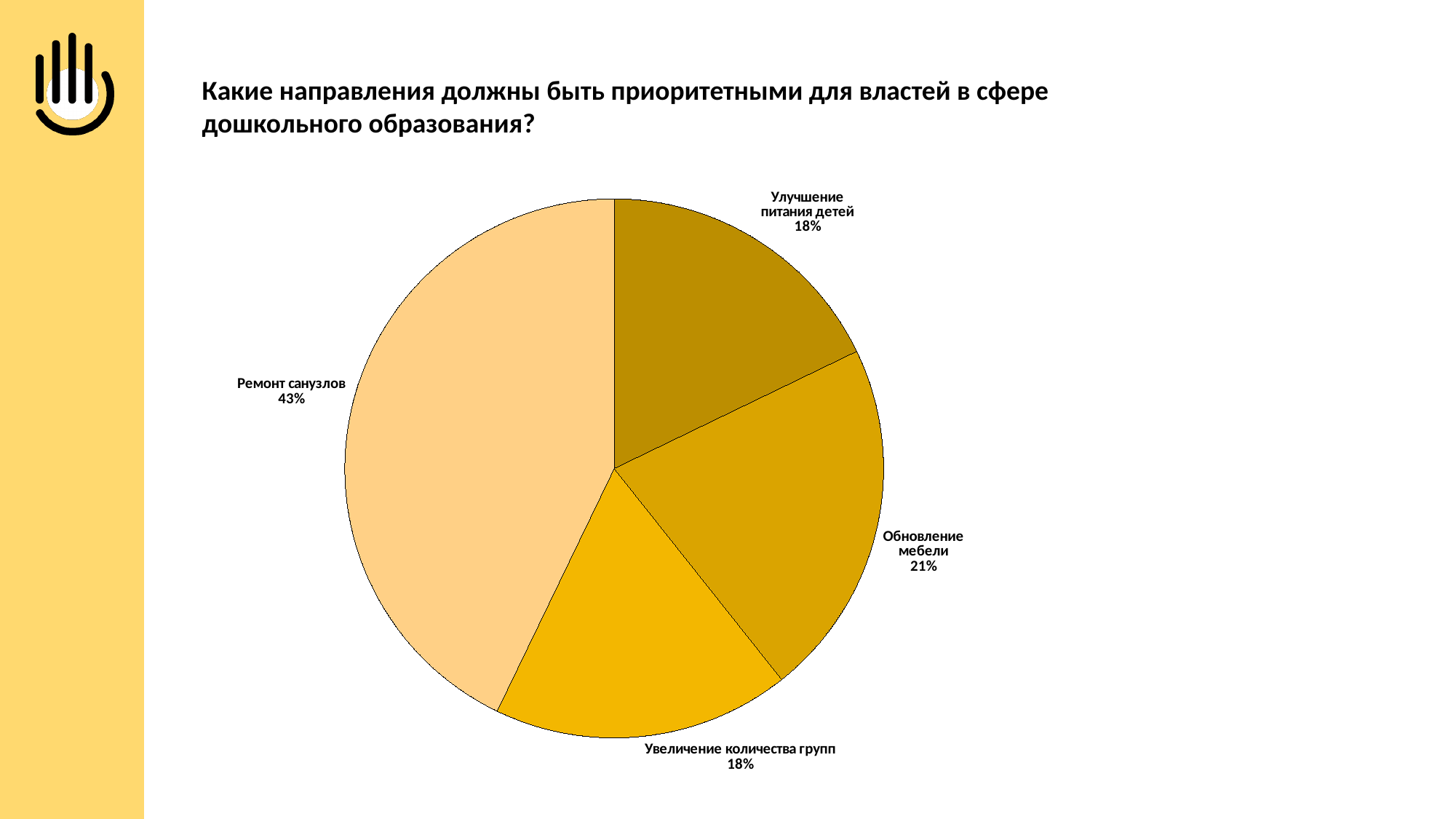
What is the difference in percentage points between "Ремонт санузлов" and "Обновление мебели"? 22 What kind of chart is shown on the slide? pie chart What question is the chart's title asking? Какие направления должны быть приоритетными для властей в сфере дошкольного образования? Is the share for "Ремонт санузлов" greater or less than 50%? less How many slices does the pie chart have? 4 Which category has the largest slice of the pie? Ремонт санузлов What share of the pie does "Ремонт санузлов" take? 43% What is the value shown for "Улучшение питания детей"? 18% What is the value shown for "Увеличение количества групп"? 18% Which is larger, the slice for "Обновление мебели" or the slice for "Улучшение питания детей"? Обновление мебели What is the value shown for "Обновление мебели"? 21% What is the difference in percentage points between "Обновление мебели" and "Увеличение количества групп"? 3